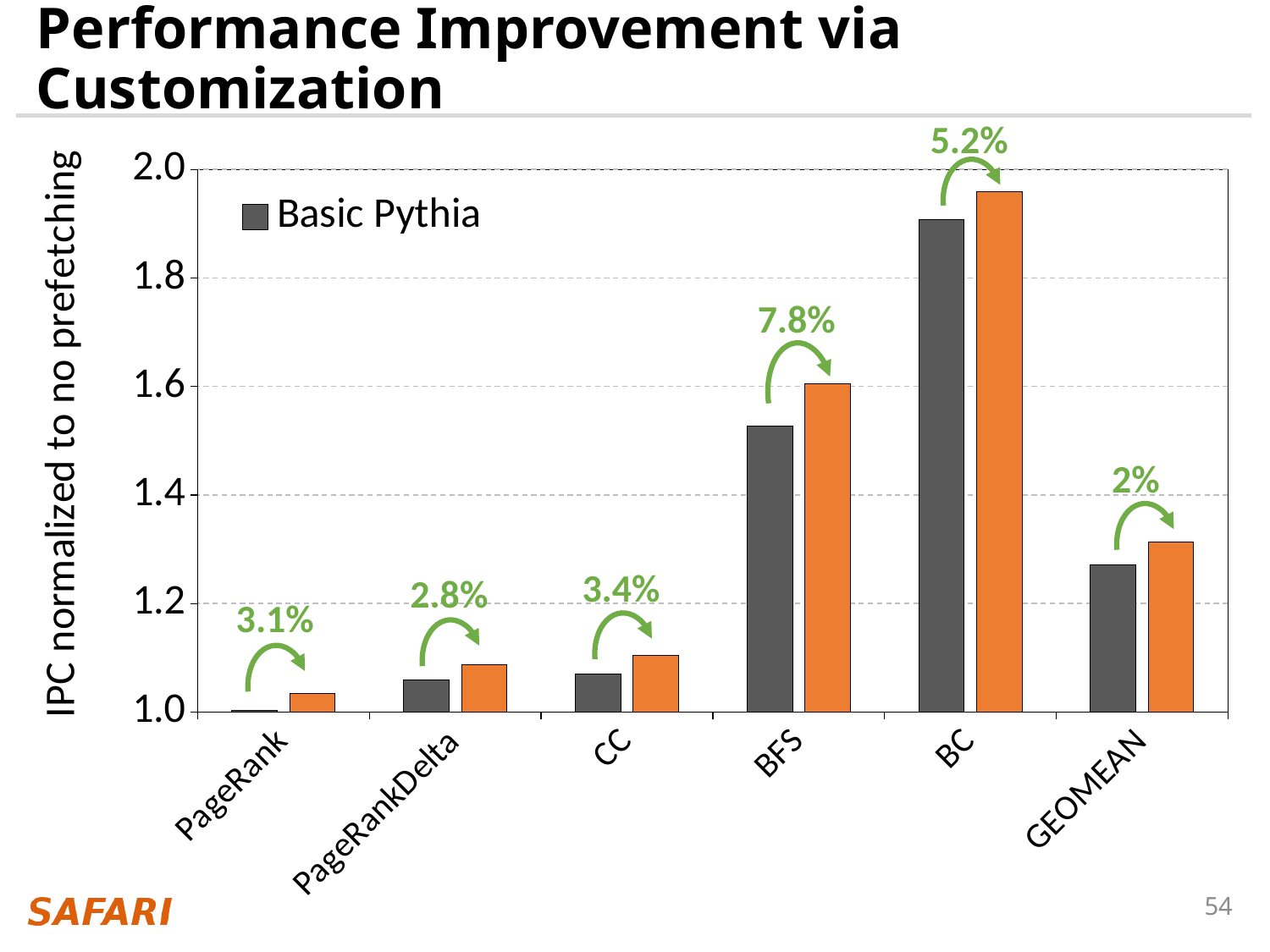
What improvement percentage is annotated above the BFS bars? 7.8% What is the y-axis label of the chart? IPC normalized to no prefetching How many series does the legend list? 1 What is the series name shown in the legend? Basic Pythia What kind of chart is shown on the slide? bar chart Is the Basic Pythia value for BC greater or less than 1.8? greater Which category has the highest Basic Pythia bar? BC What improvement percentage is annotated above the PageRankDelta bars? 2.8% Which category has the highest annotated improvement percentage? BFS Which category has the lowest Basic Pythia bar? PageRank How many categories are shown on the x axis? 6 What improvement percentage is annotated above the GEOMEAN bars? 2%